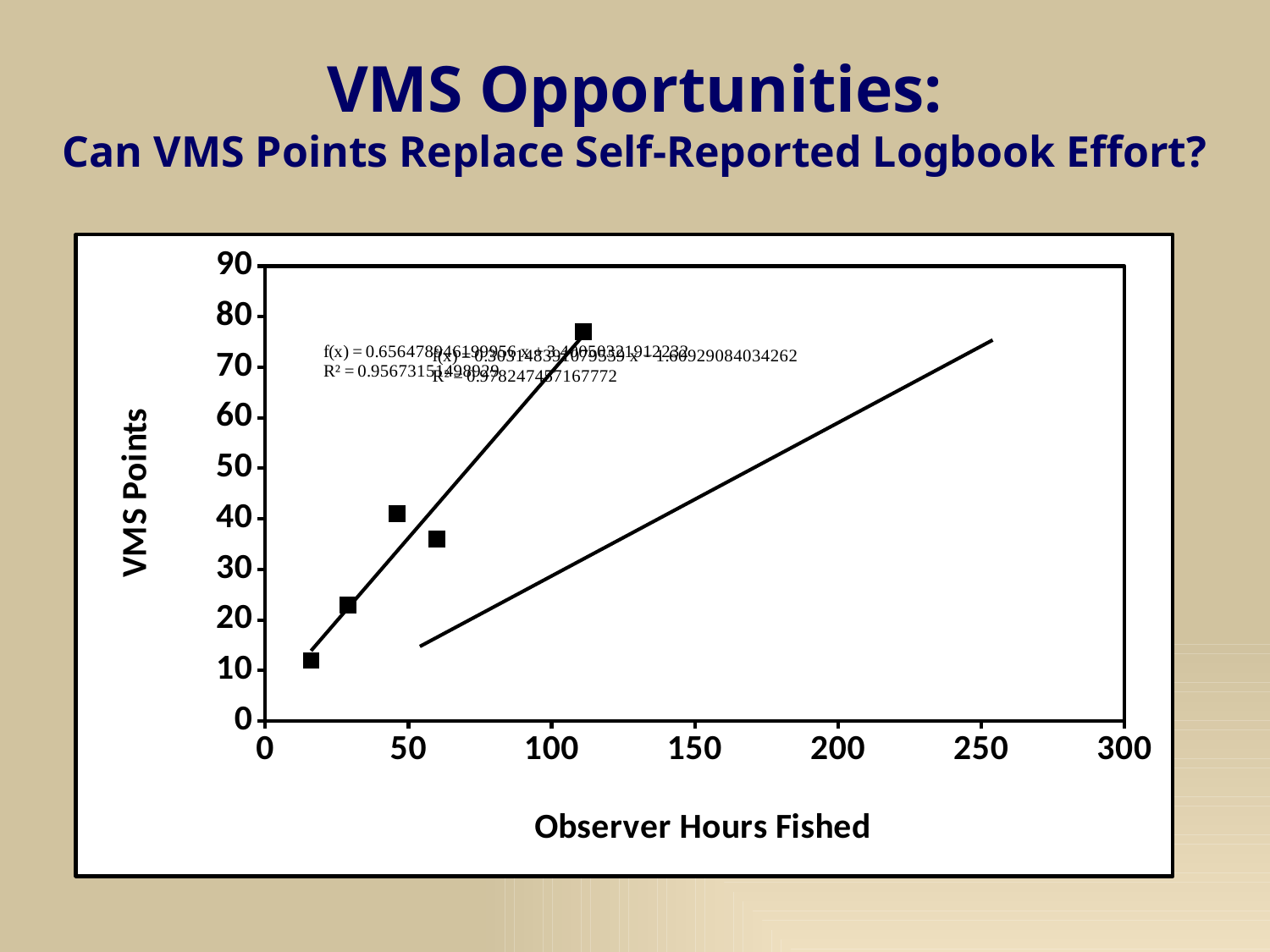
Is the VMS Points value of the lowest plotted point greater or less than 20? less What kind of chart is shown on the slide? scatter chart How many data points (square markers) are plotted on the chart? 5 Is the VMS Points value of the highest plotted point greater or less than 70? greater What is the title of the y axis? VMS Points How many trend lines are drawn on the chart? 2 What is the highest tick value shown on the x axis? 300 Are all plotted points located at Observer Hours Fished values less than 150? yes What is the title of the x axis? Observer Hours Fished Do VMS Points generally rise or fall as Observer Hours Fished increases? rise